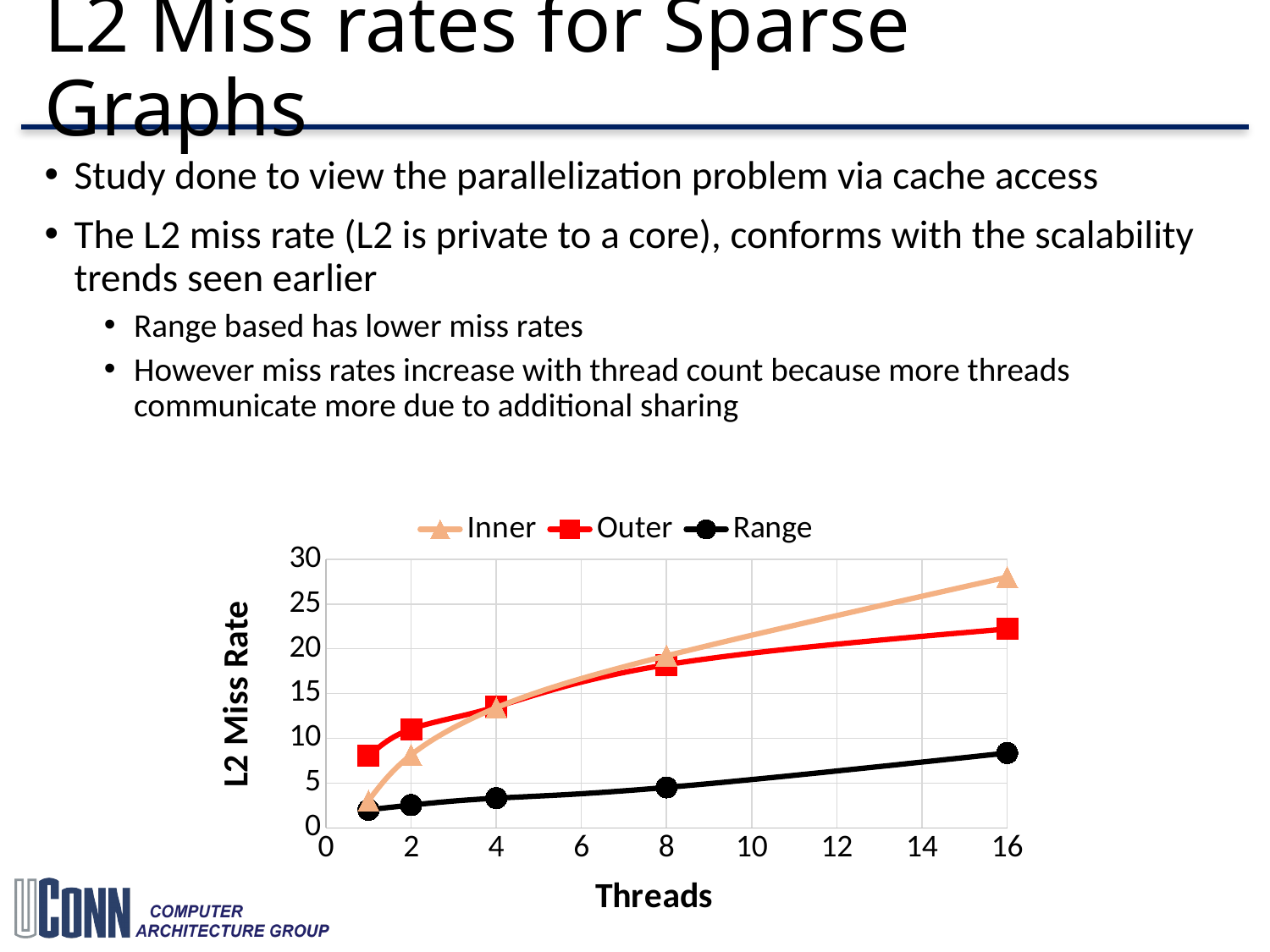
Does the L2 miss rate for the Inner series rise or fall as the thread count increases? rise What kind of chart is shown on the slide? line chart What is the title of the vertical axis? L2 Miss Rate Is the L2 miss rate for Outer at 16 threads greater or less than 25? less Which series has the lowest L2 miss rate at 16 threads? Range At 16 threads, which series has the higher L2 miss rate, Inner or Outer? Inner How many series does the legend list? 3 Is the L2 miss rate for Outer at 1 thread greater or less than 5? greater How many data points are plotted for the Range series? 5 At 1 thread, which series has the higher L2 miss rate, Inner or Outer? Outer Is the L2 miss rate for Range at 16 threads greater or less than 10? less